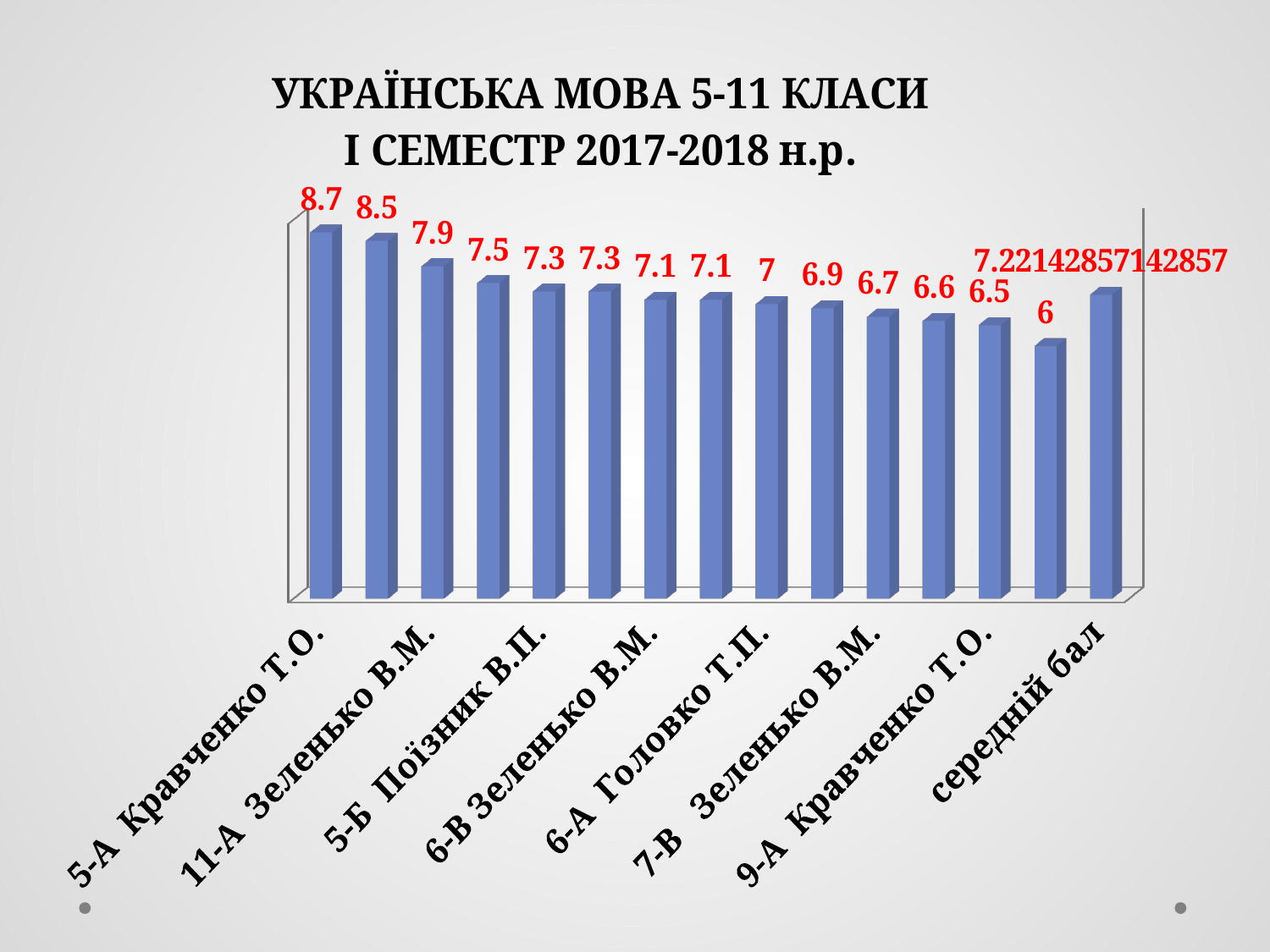
What is the lowest value labelled on any bar in the chart? 6 What kind of chart is shown on the slide? Bar chart Which category has the highest value? 5-А Кравченко Т.О. How many bars are plotted in the chart? 15 What is the value for 9-А Кравченко Т.О.? 6.5 What is the title of the chart? УКРАЇНСЬКА МОВА 5-11 КЛАСИ І СЕМЕСТР 2017-2018 н.р. Which is larger, the value for 7-В Зеленько В.М. or the value for 9-А Кравченко Т.О.? 7-В Зеленько В.М. What is the value for 5-А Кравченко Т.О.? 8.7 What is the value shown for середній бал? 7.22142857142857 What is the difference between the values for 5-А Кравченко Т.О. and 11-А Зеленько В.М.? 0.8 What is the value for 6-А Головко Т.П.? 7 What is the value for 11-А Зеленько В.М.? 7.9